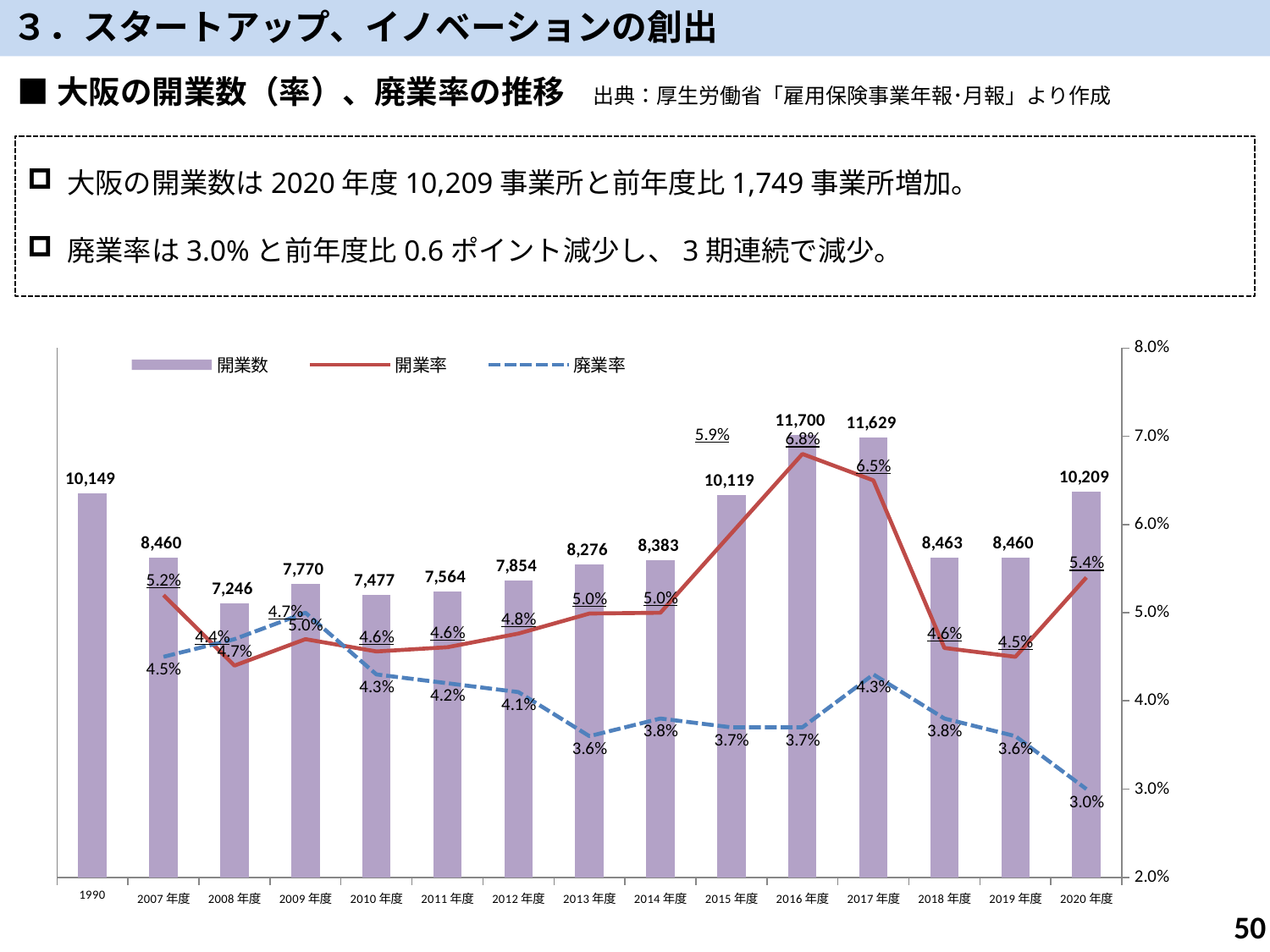
What kind of chart is this? Combined bar and line chart What is the 開業率 for 2020年度? 5.4% Which is larger, the 開業数 for 2015年度 or for 1990? 1990 What is the value of 開業数 for 2016年度? 11,700 Does the 廃業率 rise or fall from 2017年度 to 2020年度? Fall How many categories are shown on the x axis? 15 Which year has the highest 開業数? 2016年度 What is the difference in 開業数 between 2020年度 and 2019年度? 1,749 Which year has the lowest 廃業率? 2020年度 Which series is drawn as a dashed line? 廃業率 What is the 廃業率 for 2013年度? 3.6% How many series does the legend list? 3